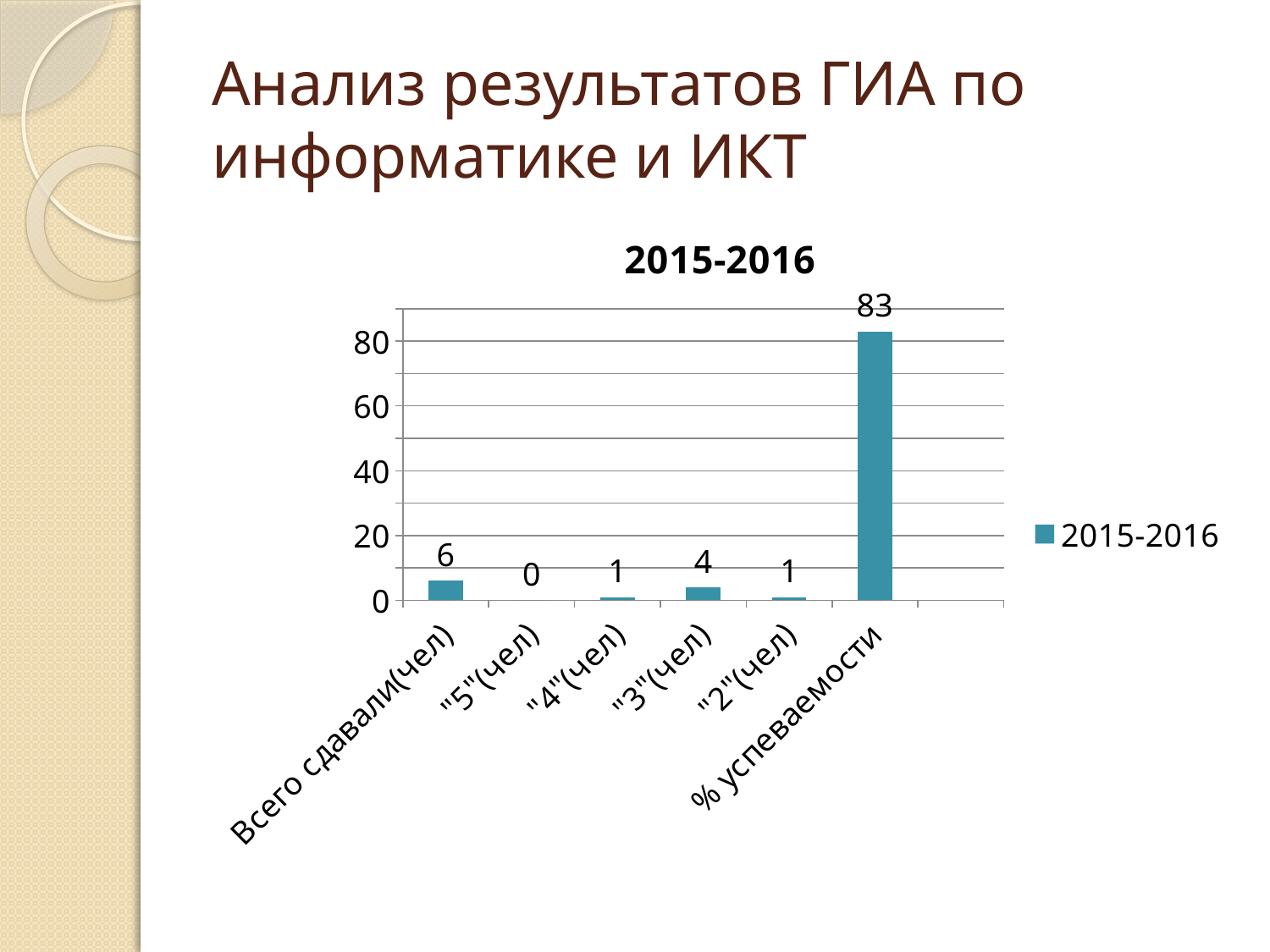
Which category has the lowest value? "5"(чел) What is the value for "Всего сдавали(чел)"? 6 What is the value for "5"(чел)? 0 What is the difference between the values for "Всего сдавали(чел)" and "3"(чел)? 2 What is the value for "% успеваемости"? 83 Is the value for "% успеваемости" greater or less than 60? greater What kind of chart is shown on the slide? bar chart How many categories are shown on the x axis? 6 What is the value for "3"(чел)? 4 What is the title of the chart? 2015-2016 Which category has the highest value? % успеваемости Which is larger, the value for "4"(чел) or the value for "3"(чел)? "3"(чел)